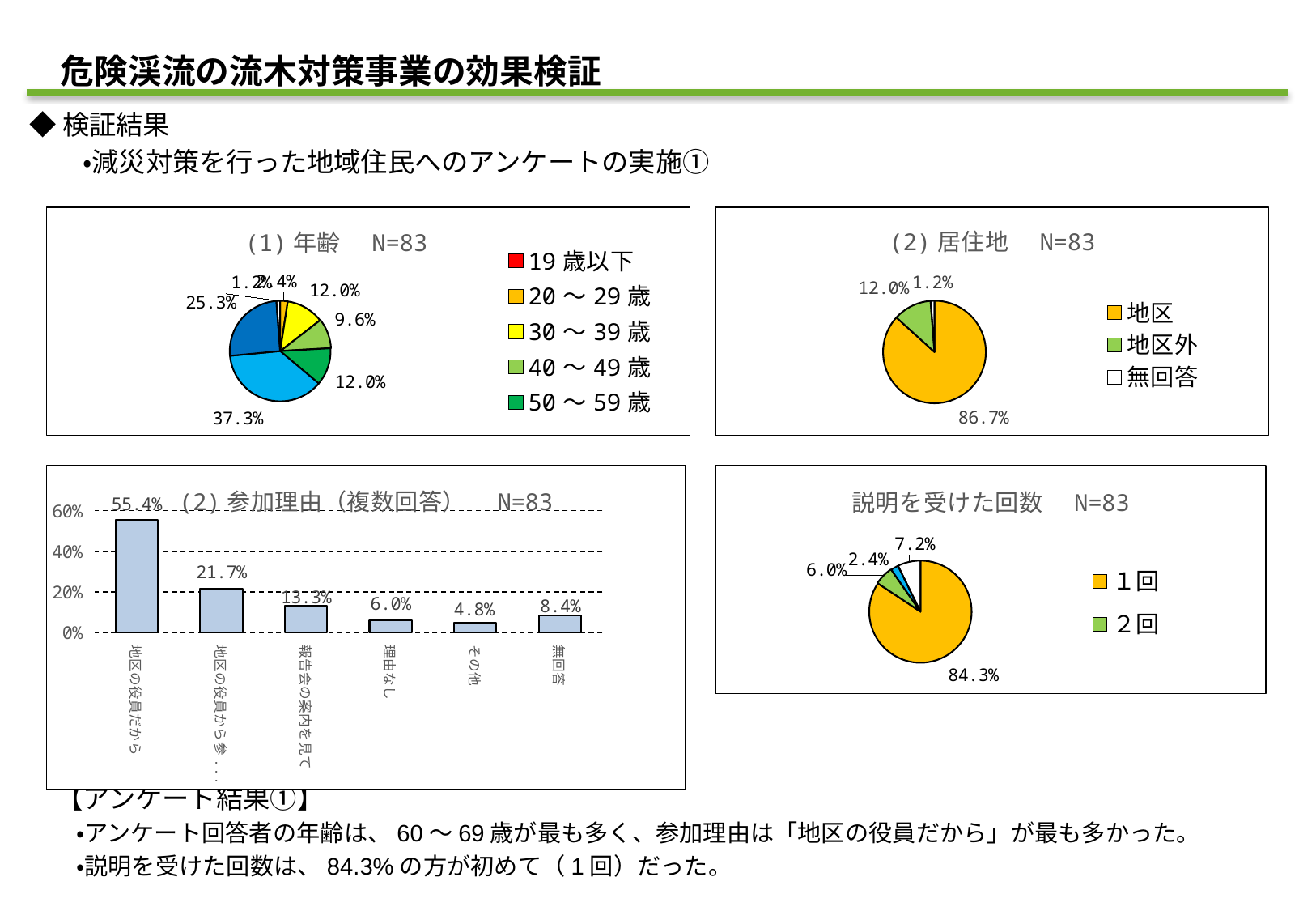
In the pie chart titled (2) 居住地, what is the value for 地区外? 12.0% What kind of chart is the chart titled (2) 参加理由（複数回答）? bar chart In the bar chart titled (2) 参加理由（複数回答）, how many categories are shown? 6 In the bar chart titled (2) 参加理由（複数回答）, what is the value for 地区の役員だから? 55.4% In the bar chart titled (2) 参加理由（複数回答）, which category has the lowest value? その他 In the bar chart titled (2) 参加理由（複数回答）, what is the difference between 地区の役員だから and 無回答? 47.0% In the pie chart titled (1) 年齢, what is the largest slice's value? 37.3% In the bar chart titled (2) 参加理由（複数回答）, what is the value for 報告会の案内を見て? 13.3% In the bar chart titled (2) 参加理由（複数回答）, is the value for 地区の役員から参… greater or less than 20%? greater In the pie chart titled (2) 居住地, how many entries does the legend list? 3 In the pie chart titled (2) 居住地, what share does 地区 have? 86.7% In the pie chart titled 説明を受けた回数, what share does 1回 have? 84.3%